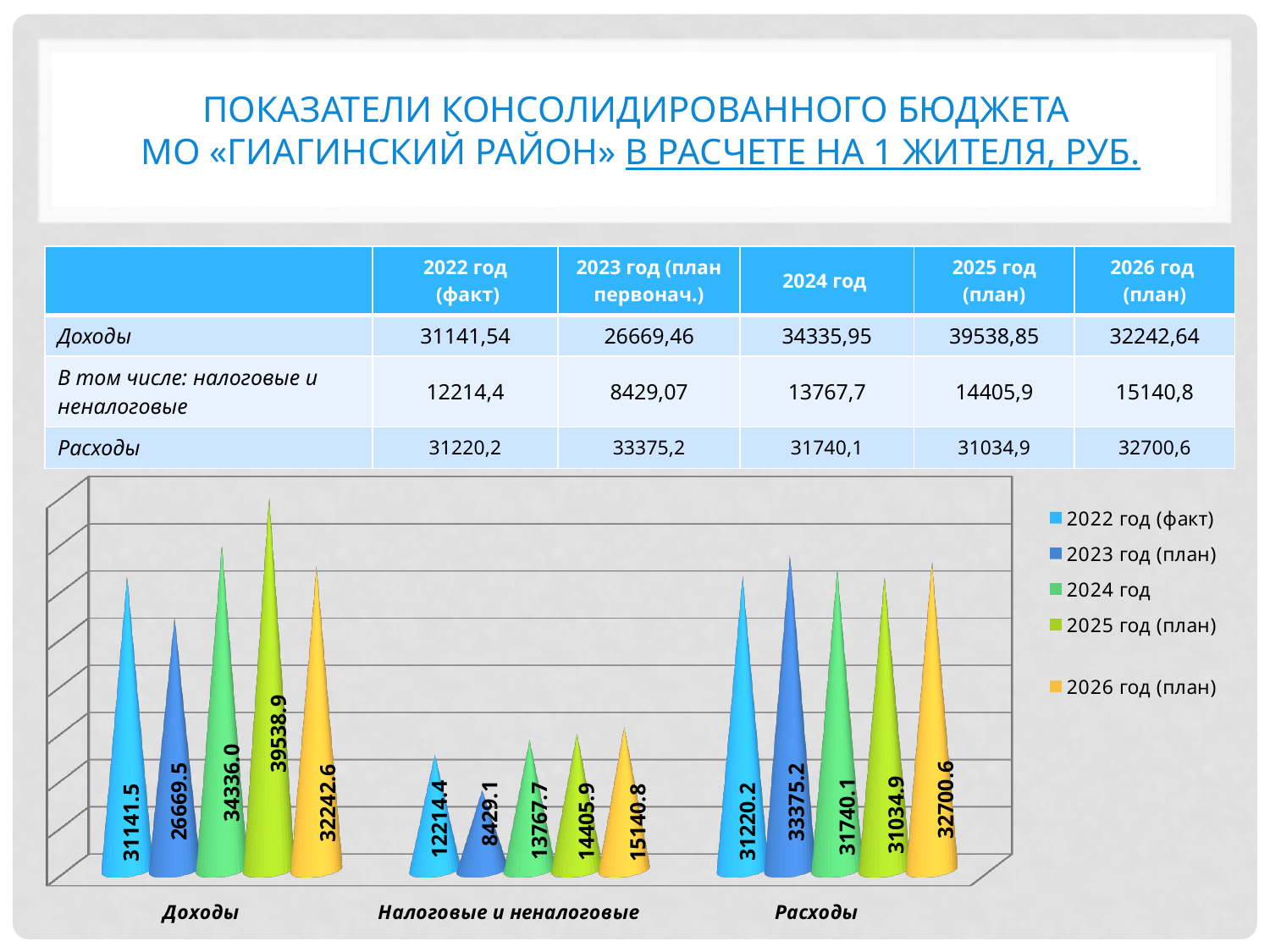
What kind of chart is shown on the slide? bar chart Which series has the highest value for Расходы on the chart? 2023 год (план) What is the value for Расходы in the 2026 год (план) series on the chart? 32700.6 Do the values for Налоговые и неналоговые rise or fall from 2023 год (план) to 2026 год (план) on the chart? rise Which is larger on the chart: Доходы for 2024 год or Расходы for 2024 год? Доходы for 2024 год Which series has the lowest value for Налоговые и неналоговые on the chart? 2023 год (план) What is the difference between the 2026 год (план) and 2022 год (факт) values for Налоговые и неналоговые on the chart? 2926.4 How many categories are shown on the x axis of the chart? 3 What is the value for Налоговые и неналоговые in the 2023 год (план) series on the chart? 8429.1 How many series does the chart legend list? 5 What is the value for Доходы in the 2025 год (план) series on the chart? 39538.9 Which series has the highest value for Доходы on the chart? 2025 год (план)